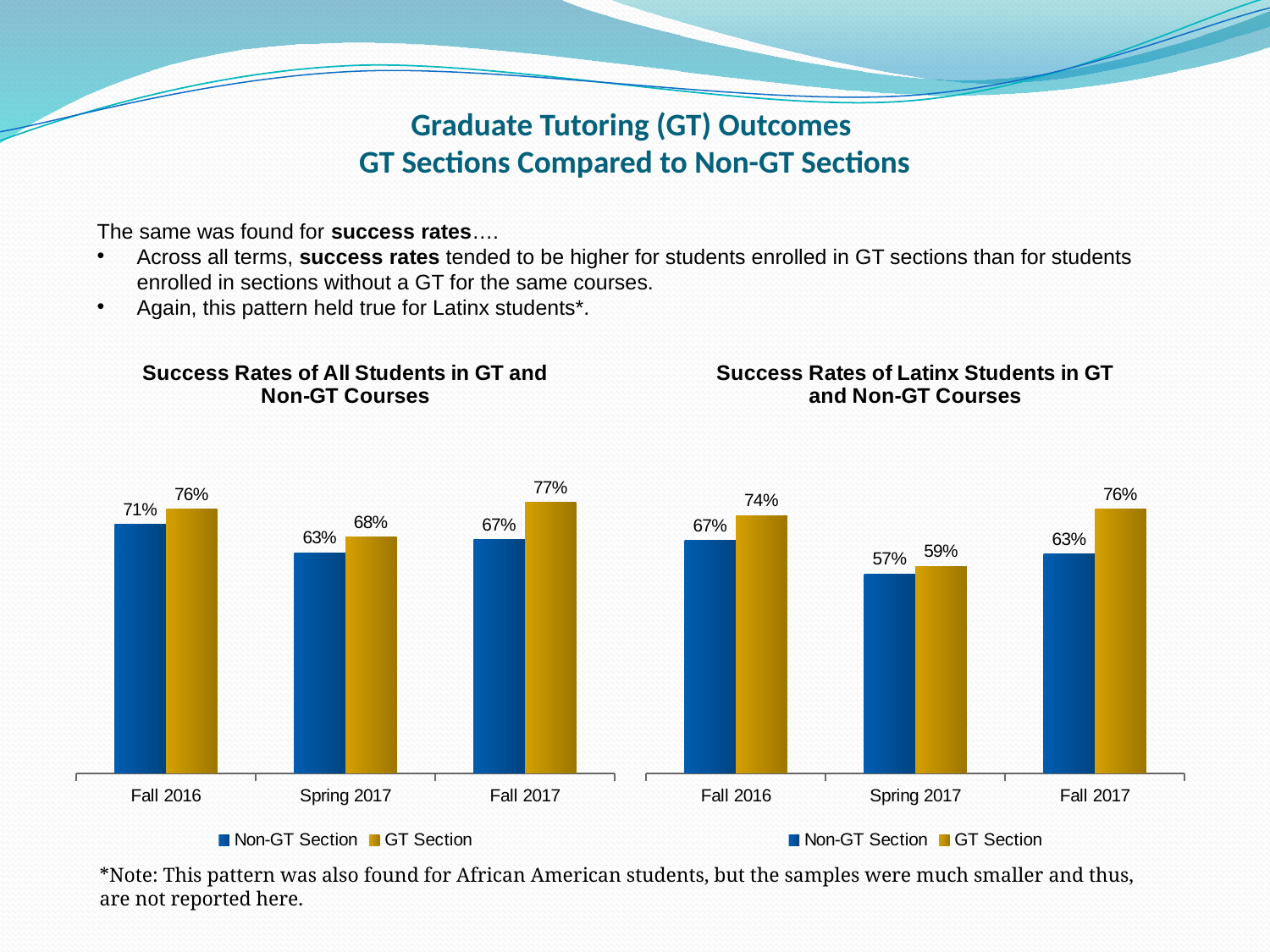
In the 'Success Rates of Latinx Students in GT and Non-GT Courses' chart, what is the success rate for the GT Section in Fall 2016? 74% How many terms are shown on the x axis of the 'Success Rates of Latinx Students in GT and Non-GT Courses' chart? 3 How many series does the legend of the 'Success Rates of All Students in GT and Non-GT Courses' chart list? 2 In the 'Success Rates of Latinx Students in GT and Non-GT Courses' chart, which term has the lowest Non-GT Section success rate? Spring 2017 In the 'Success Rates of All Students in GT and Non-GT Courses' chart, what is the success rate for the Non-GT Section in Spring 2017? 63% In the 'Success Rates of Latinx Students in GT and Non-GT Courses' chart, what is the difference between the GT Section and Non-GT Section success rates in Fall 2017? 13% In the 'Success Rates of All Students in GT and Non-GT Courses' chart, what is the success rate for the GT Section in Fall 2017? 77% In the 'Success Rates of All Students in GT and Non-GT Courses' chart, which term has the highest GT Section success rate? Fall 2017 In the 'Success Rates of All Students in GT and Non-GT Courses' chart, what is the difference between the GT Section and Non-GT Section success rates in Fall 2016? 5% What kind of chart is the 'Success Rates of Latinx Students in GT and Non-GT Courses' chart? Bar chart In the 'Success Rates of All Students in GT and Non-GT Courses' chart, which is larger in Spring 2017: the GT Section or the Non-GT Section success rate? GT Section In the 'Success Rates of Latinx Students in GT and Non-GT Courses' chart, what is the success rate for the Non-GT Section in Spring 2017? 57%